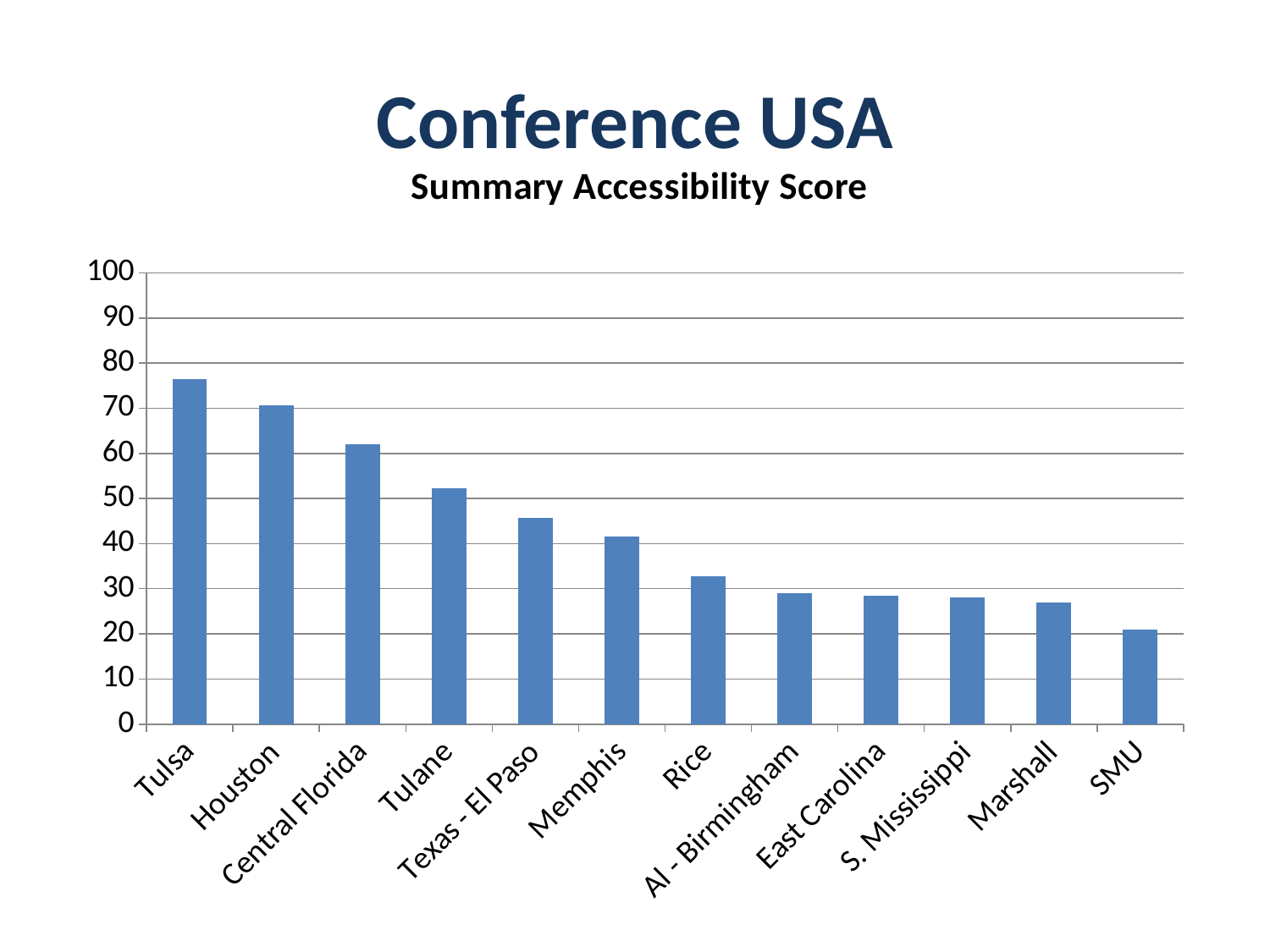
Is the value for Tulsa greater or less than 70? greater Which has a higher score, Tulsa or Houston? Tulsa Which school has the highest Summary Accessibility Score? Tulsa Is the value for Texas - El Paso greater or less than 40? greater Is the value for Marshall greater or less than 30? less Do the values rise or fall moving from left to right along the x axis? fall What kind of chart is shown on the slide? bar chart Which has a higher score, Memphis or Rice? Memphis Which school has the lowest Summary Accessibility Score? SMU How many schools are shown on the x axis of the chart? 12